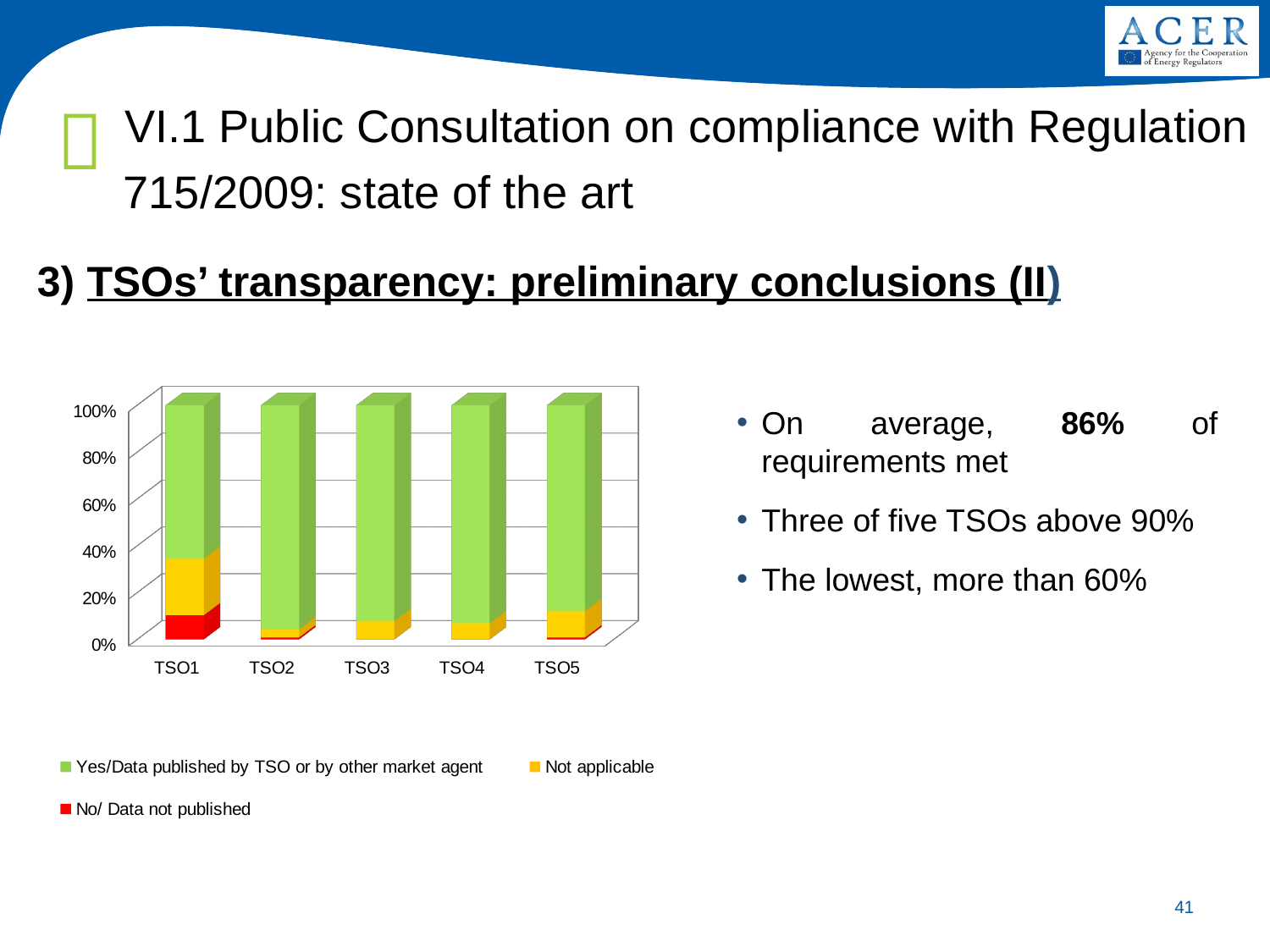
Which TSO has the smallest 'Yes/Data published by TSO or by other market agent' segment? TSO1 How many series does the chart legend list? 3 How many TSOs are shown on the x axis of the chart? 5 Is the 'Not applicable' value for TSO5 greater or less than 20%? less Which TSO has the largest 'Not applicable' segment? TSO1 What is the total height of the stacked bar for TSO3? 100% Which colour represents 'Not applicable' in the chart legend? Yellow Is the 'Yes/Data published by TSO or by other market agent' value for TSO1 greater or less than 60%? greater Which has a larger 'Yes/Data published by TSO or by other market agent' segment, TSO1 or TSO3? TSO3 What kind of chart is shown on the slide? Stacked bar chart Which TSO has the largest 'No/ Data not published' segment? TSO1 Is the 'Not applicable' value for TSO1 greater or less than 20%? greater